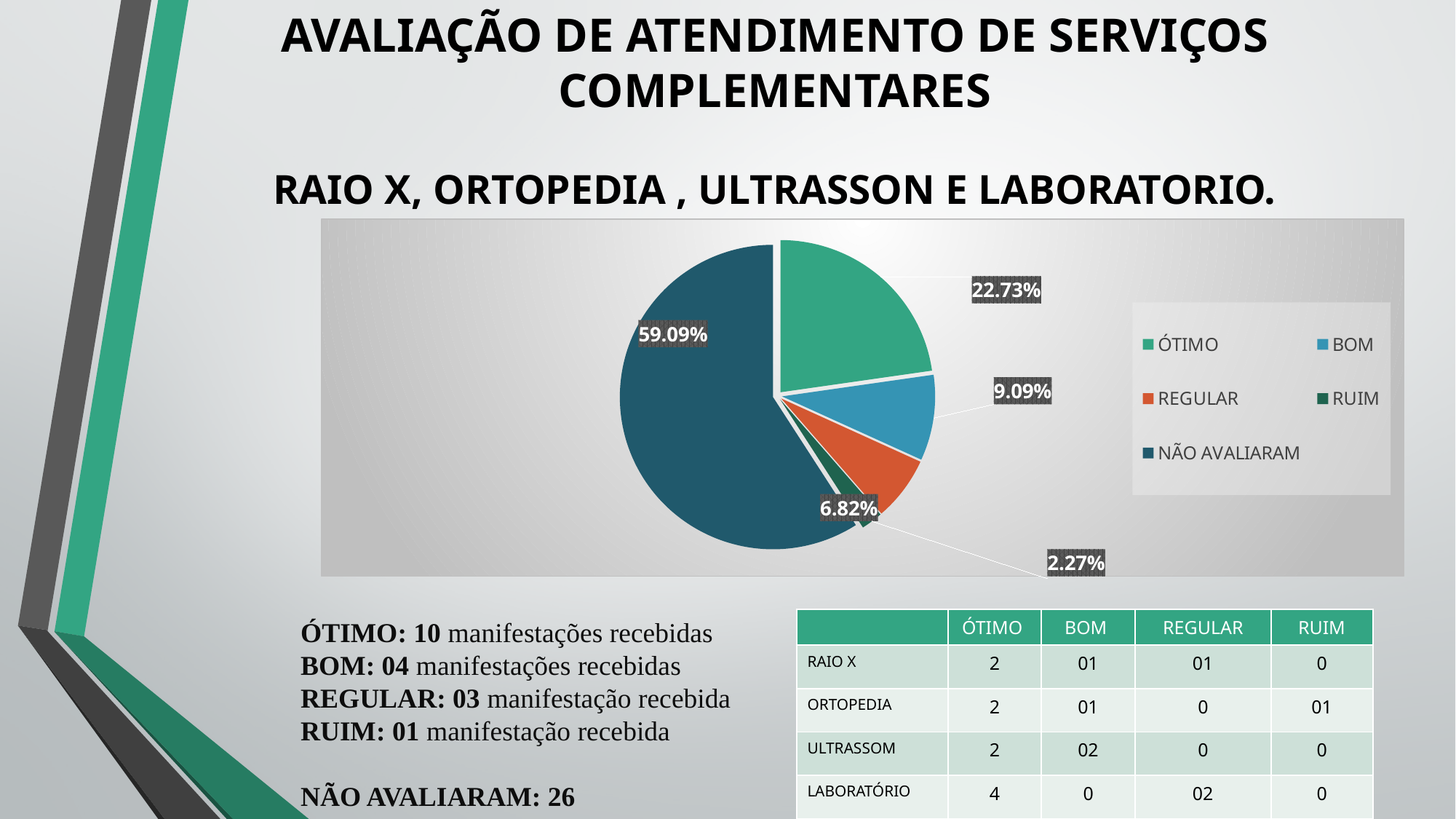
What type of chart is shown on the slide? Pie chart What is the difference in percentage points between ÓTIMO and BOM? 13.64% How many entries does the legend list? 5 What share of the pie does ÓTIMO represent? 22.73% How many slices does the pie chart have? 5 What percentage is shown for BOM? 9.09% Which category has the largest slice of the pie? NÃO AVALIARAM Which category has the smallest slice of the pie? RUIM What percentage is shown for RUIM? 2.27% Which is larger, the BOM slice or the REGULAR slice? BOM What percentage is shown for REGULAR? 6.82% What percentage is shown for NÃO AVALIARAM? 59.09%